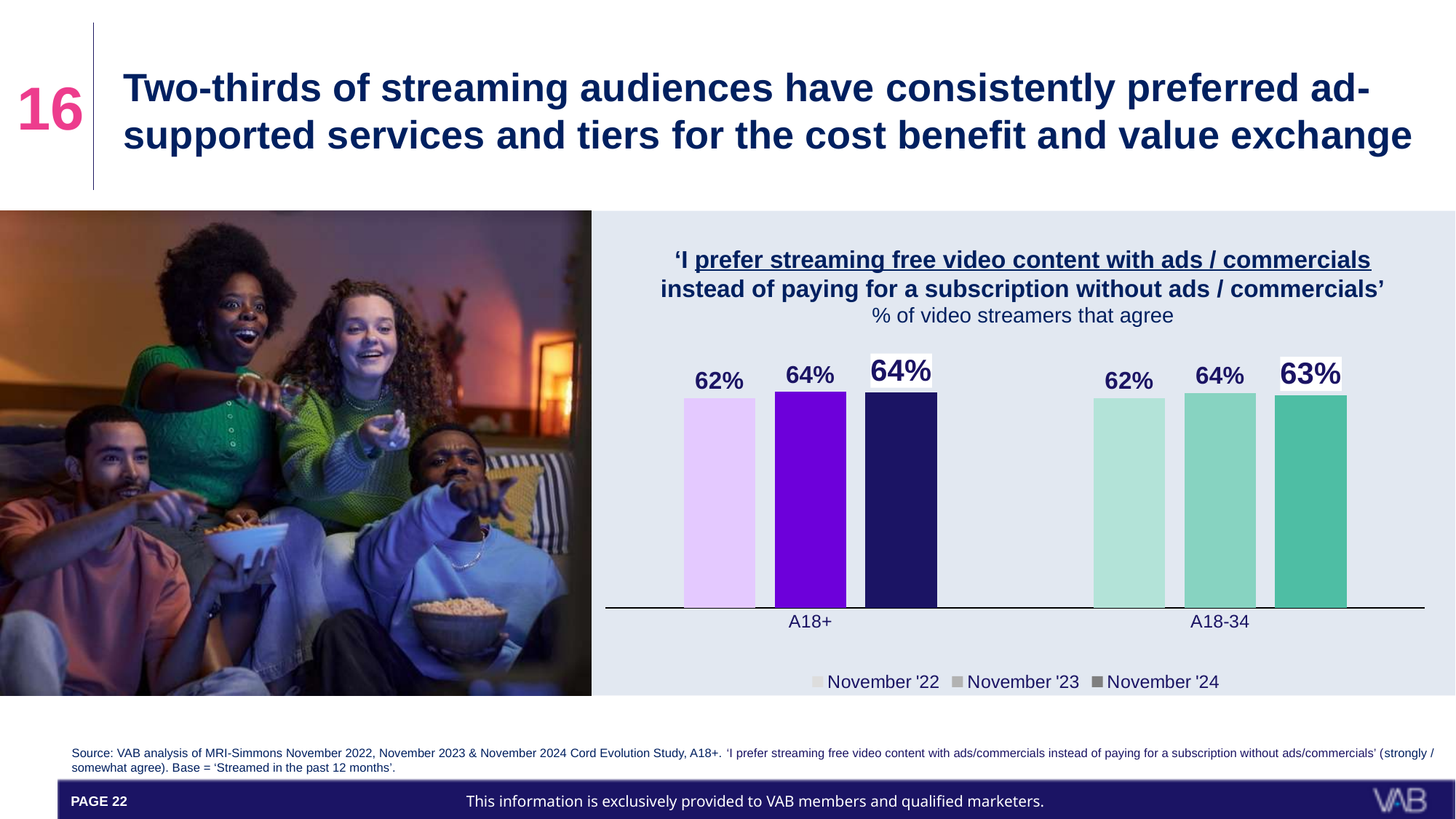
How many age groups are shown on the x axis? 2 What is the value for A18+ in November '24? 64% Did the A18+ value rise or fall from November '22 to November '23? Rise What are the three legend entries of the chart? November '22, November '23, November '24 What kind of chart is shown on the slide? Bar chart Which is larger for November '24: the A18+ value or the A18-34 value? A18+ What is the difference between the A18+ values for November '24 and November '22? 2 percentage points What is the difference between the A18-34 values for November '23 and November '24? 1 percentage point How many series does the legend list? 3 What percentage of A18+ video streamers agreed in November '22? 62% What percentage of A18-34 video streamers agreed in November '24? 63% What is the value for A18-34 in November '23? 64%